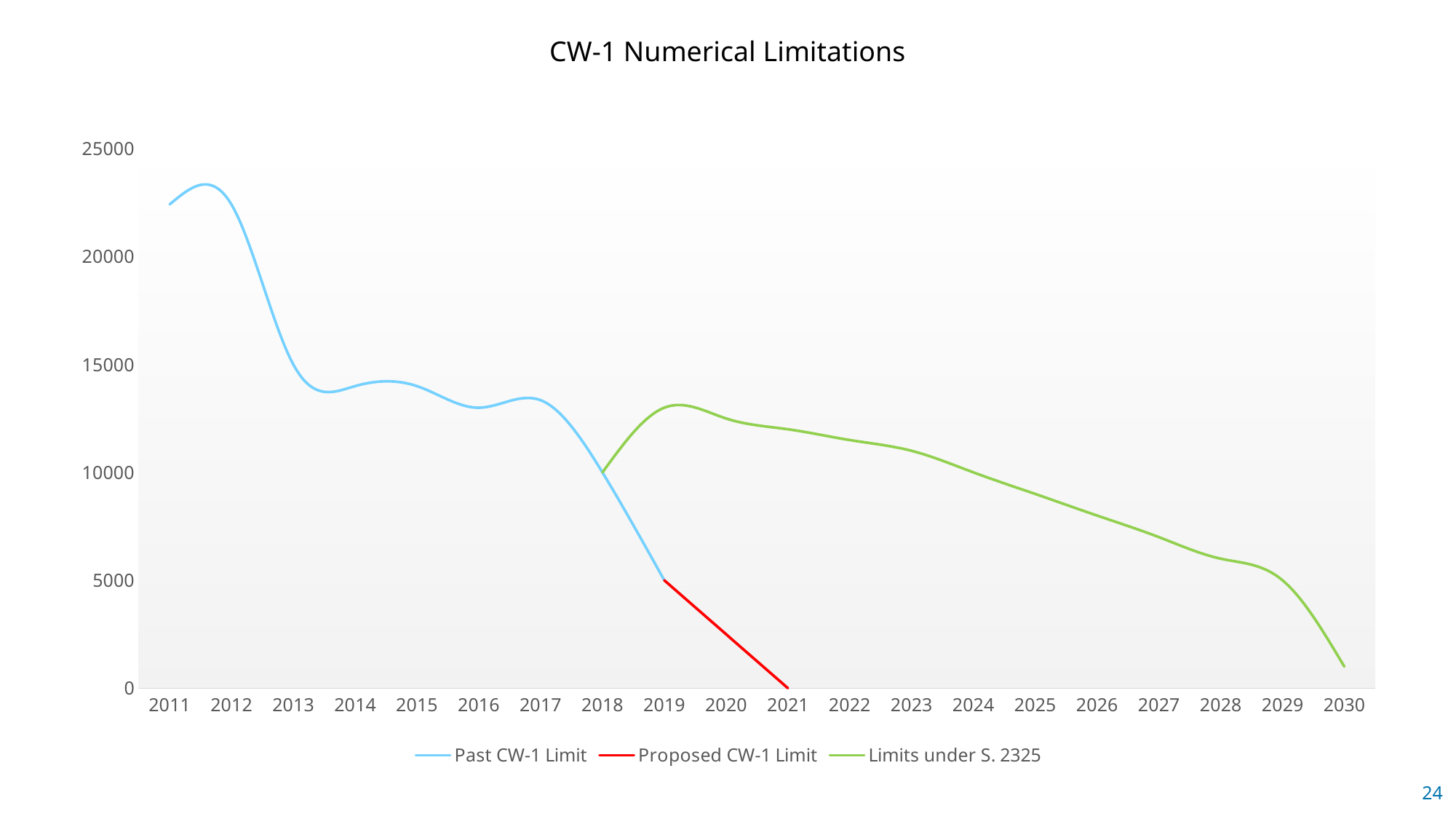
Is the value of the Past CW-1 Limit in 2011 greater or less than 20000? greater Is the value of Limits under S. 2325 in 2030 greater or less than 5000? less In which year is the Past CW-1 Limit series at its lowest? 2019 What kind of chart is shown on the slide? line chart What is the value of the Proposed CW-1 Limit in 2021? 0 In which year is the Limits under S. 2325 series at its highest? 2019 Is the value of Limits under S. 2325 in 2025 greater or less than 10000? less How many series does the legend list? 3 Which is larger for Limits under S. 2325: the value in 2020 or the value in 2028? 2020 How many years are shown on the x axis? 20